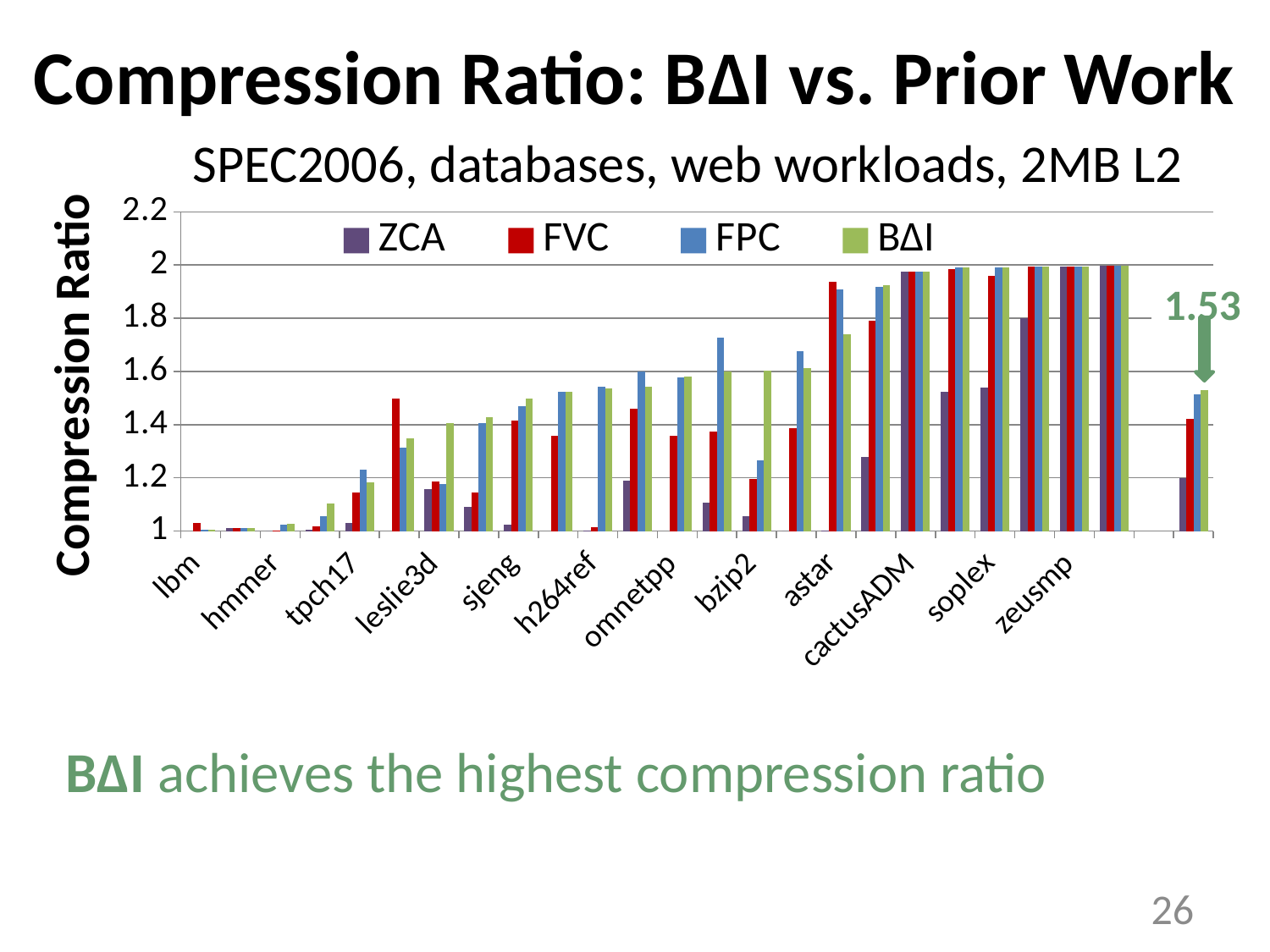
What kind of chart is shown on the slide? bar chart For astar, which series has the lowest compression ratio? ZCA For bzip2, which is larger: the FPC value or the BΔI value? BΔI What are the four series named in the chart legend? ZCA, FVC, FPC, BΔI What is the label on the vertical axis of the chart? Compression Ratio Is the ZCA value for cactusADM greater or less than 1.4? greater What value is annotated above the rightmost group of bars in the chart? 1.53 Is the FPC value for bzip2 greater or less than 1.6? less Is the ZCA value for soplex greater or less than 1.4? greater How many series does the chart legend list? 4